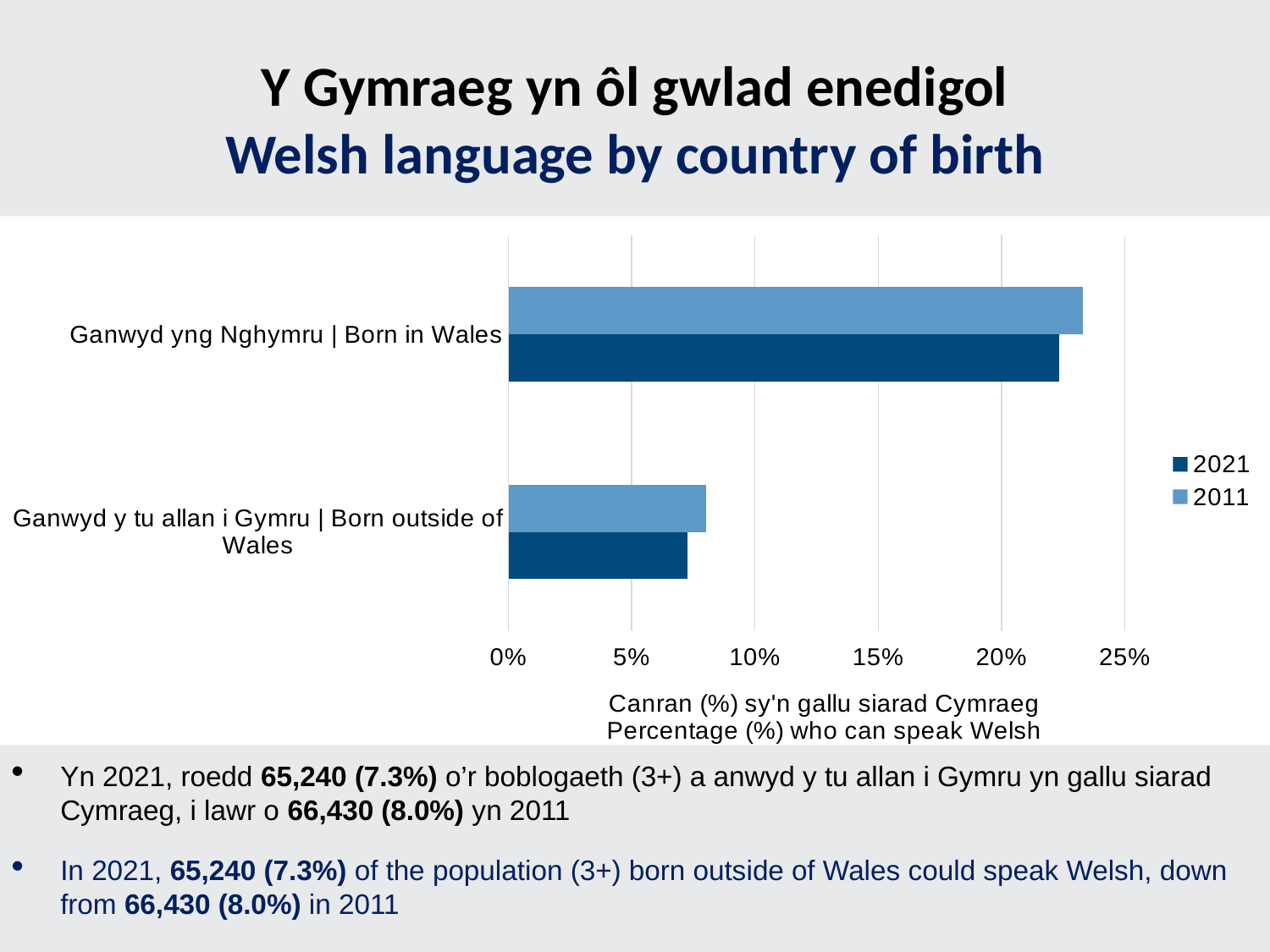
Which category has the highest percentage who can speak Welsh? Ganwyd yng Nghymru | Born in Wales What percentage of the population born outside of Wales could speak Welsh in 2011? 8.0% Which series is shown in the darker blue colour? 2021 How many categories (countries of birth) are shown on the chart? 2 What kind of chart is shown on the slide? Bar chart Is the 2021 value for Born in Wales greater or less than 20%? greater Is the 2011 value for Born outside of Wales greater or less than 10%? less What is the label on the horizontal axis of the chart? Canran (%) sy'n gallu siarad Cymraeg / Percentage (%) who can speak Welsh For those born in Wales, which year shows the larger percentage who can speak Welsh, 2021 or 2011? 2011 By how many percentage points did the share of Welsh speakers born outside of Wales fall between 2011 and 2021? 0.7 percentage points How many series does the chart legend list? 2 What percentage of the population born outside of Wales could speak Welsh in 2021? 7.3%